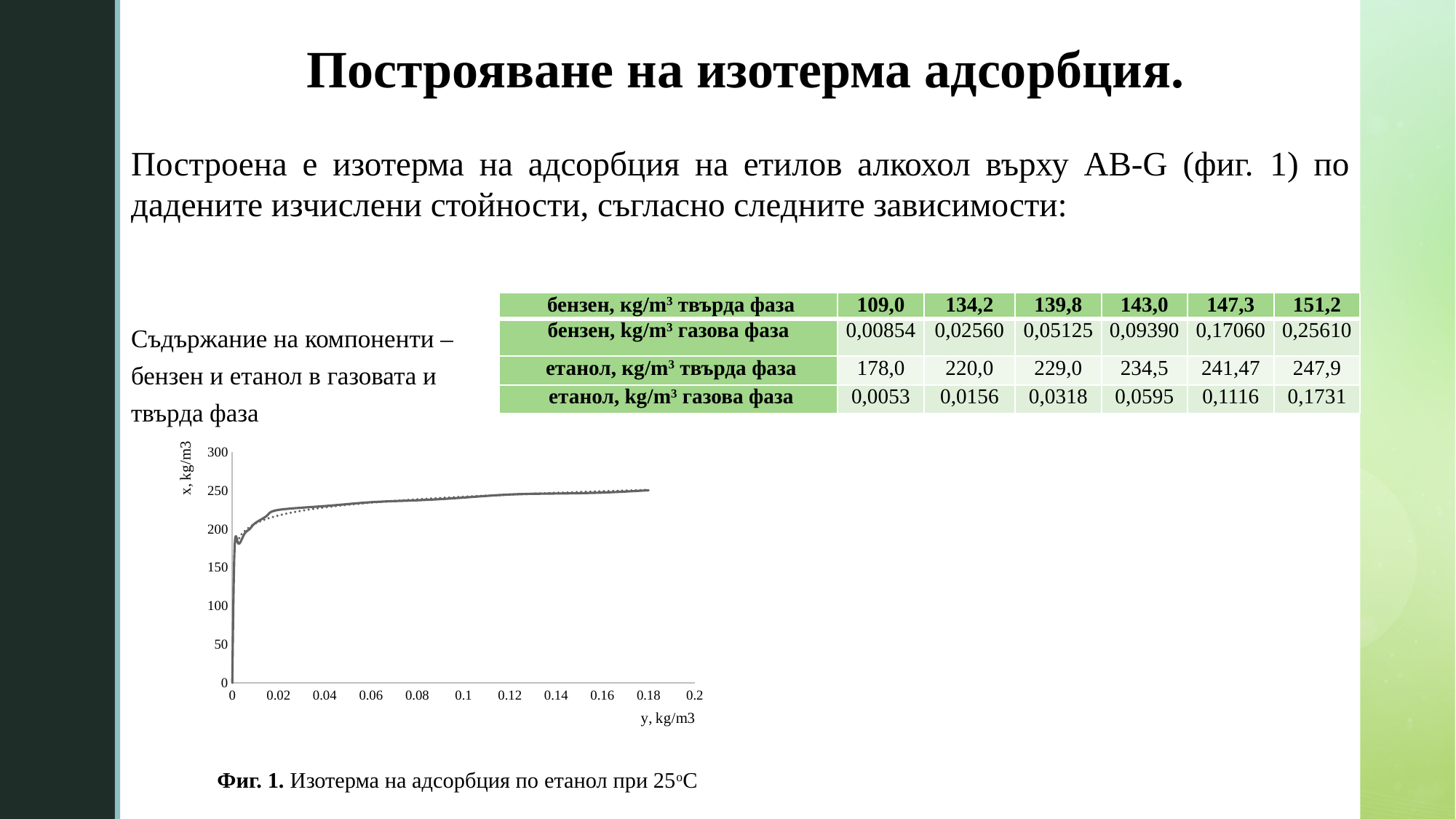
Is the plotted value at y = 0.04 kg/m3 greater or less than 100? greater What is the label of the horizontal axis of the chart? y, kg/m3 Is the plotted value at y = 0.18 kg/m3 greater or less than 200? greater Do the plotted values rise or fall as the x axis value increases? rise Is the plotted value at y = 0.18 kg/m3 greater or less than 300? less What kind of chart is shown on the slide? line chart What is the label of the vertical axis of the chart? x, kg/m3